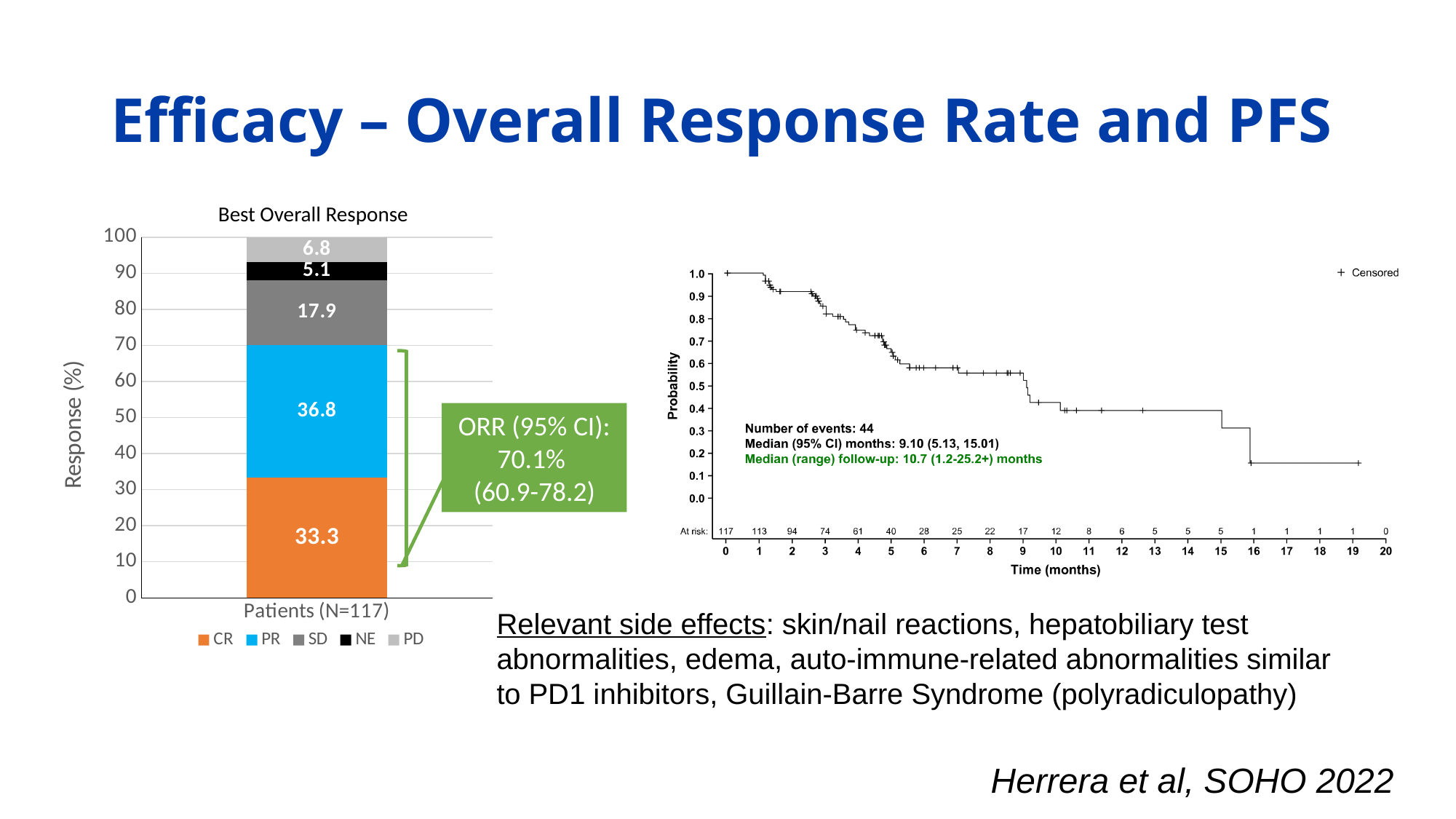
In the Best Overall Response chart, is the value for SD larger or the value for PD larger? SD In the Best Overall Response chart, which response category has the largest value? PR What kind of chart is the Best Overall Response chart? Stacked bar chart In the PFS chart on the right, does the probability rise or fall as time increases? Fall How many series does the legend of the Best Overall Response chart list? 5 In the Best Overall Response chart, what is the difference between the PR and CR values? 3.5 In the Best Overall Response chart, what is the value for PR? 36.8 In the PFS chart on the right, how many patients are at risk at 9 months? 17 In the Best Overall Response chart, what is the value for SD? 17.9 In the Best Overall Response chart, what is the combined value of CR and PR? 70.1 In the Best Overall Response chart, what is the value for CR? 33.3 In the Best Overall Response chart, which response category has the smallest value? NE